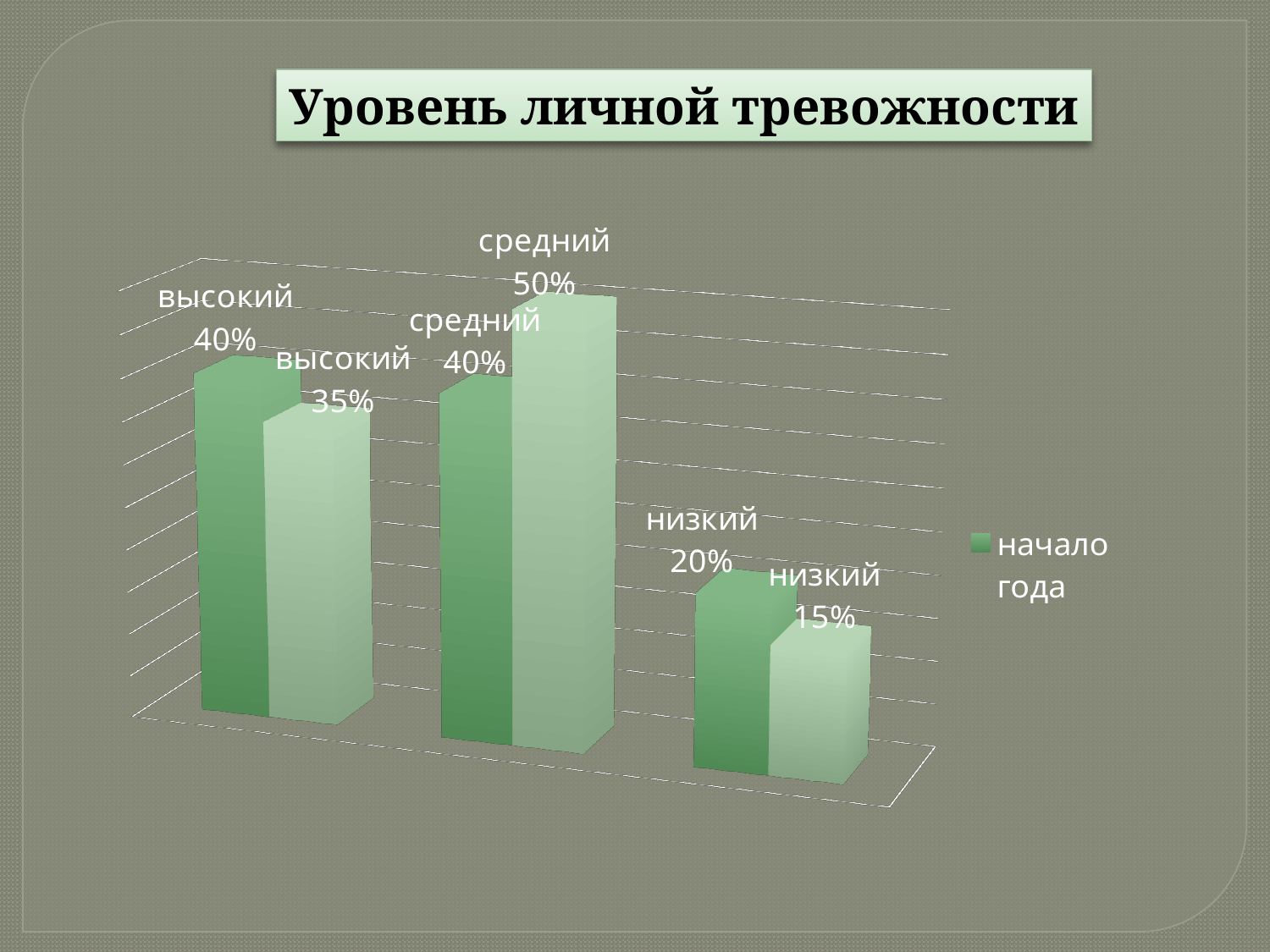
What is the value of the 'начало года' series for the category 'высокий'? 40% What is the difference between the 'начало года' values for 'высокий' and 'низкий'? 20% What is the value of the 'начало года' series for the category 'низкий'? 20% What is the difference between the two bars for the category 'средний'? 10% What is the value of the lighter green bar for the category 'низкий'? 15% What kind of chart is shown on the slide? bar chart Which category has the lowest value in the 'начало года' series? низкий For the category 'высокий', which is larger: the 'начало года' bar or the lighter green bar? начало года Which category has the highest value among the lighter green bars? средний What is the value of the lighter green bar for the category 'средний'? 50% What is the title of the chart? Уровень личной тревожности How many categories are shown on the chart? 3